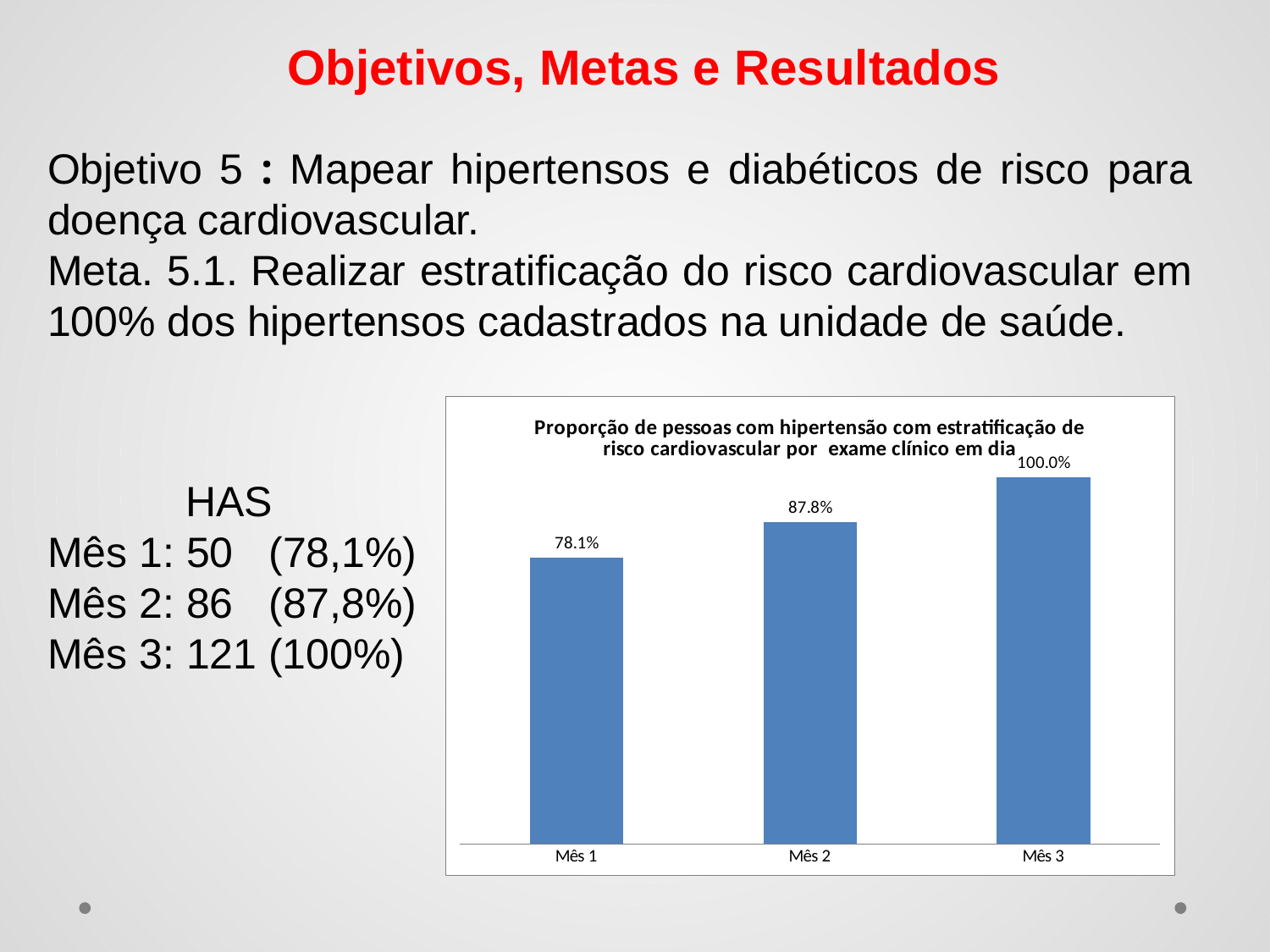
Which is larger, the value for Mês 2 or the value for Mês 1? Mês 2 What is the value for Mês 3 in the chart? 100.0% What is the value for Mês 2 in the chart? 87.8% Which month has the lowest value in the chart? Mês 1 Which month has the highest value in the chart? Mês 3 What kind of chart is shown on the slide? Bar chart How many months are shown on the x axis of the chart? 3 What is the difference between the values for Mês 2 and Mês 1? 9.7% What is the title of the chart? Proporção de pessoas com hipertensão com estratificação de risco cardiovascular por exame clínico em dia What is the value for Mês 1 in the chart? 78.1% Do the values rise or fall from Mês 1 to Mês 3? Rise What is the difference between the values for Mês 3 and Mês 1? 21.9%